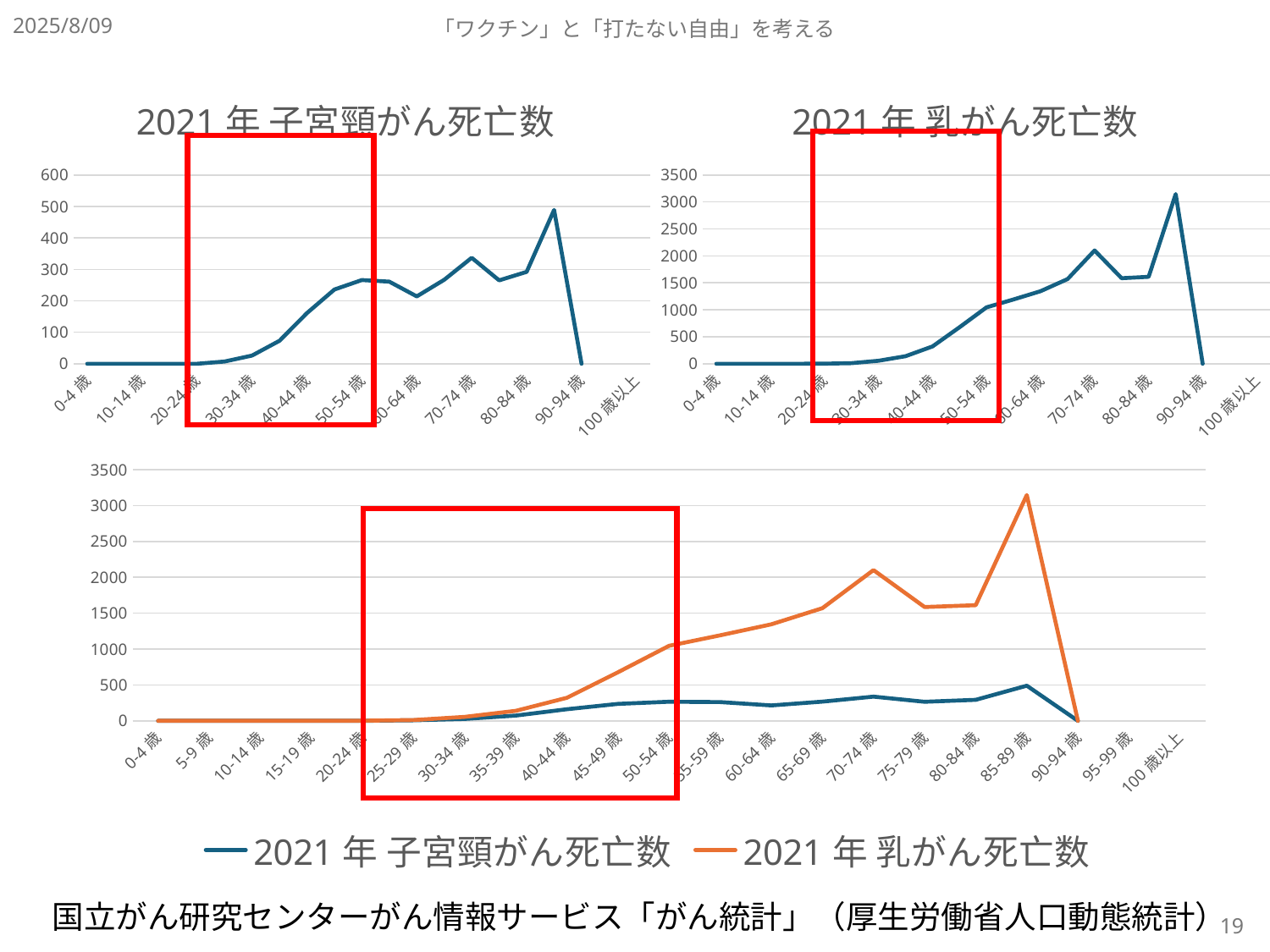
What kind of chart is the bottom chart on the slide? line chart In the bottom chart, which age group has the highest value for 2021 年 乳がん死亡数? 85-89 歳 In the bottom chart, how many age-group categories are shown on the x axis? 21 In the bottom chart, is the value for 2021 年 乳がん死亡数 at 40-44 歳 greater or less than 500? less In the chart titled 2021 年 乳がん死亡数 (top right), is the peak value greater or less than 3000? greater In the bottom chart, at 70-74 歳, which series has the larger value: 2021 年 子宮頸がん死亡数 or 2021 年 乳がん死亡数? 2021 年 乳がん死亡数 In the chart titled 2021 年 子宮頸がん死亡数 (top left), is the value for 70-74 歳 greater or less than 300? greater In the chart titled 2021 年 乳がん死亡数 (top right), do the values rise or fall from 20-24 歳 to 50-54 歳? rise In the bottom chart, which age group has the highest value for 2021 年 子宮頸がん死亡数? 85-89 歳 How many series does the legend of the bottom chart list? 2 What is the title of the top-left chart? 2021 年 子宮頸がん死亡数